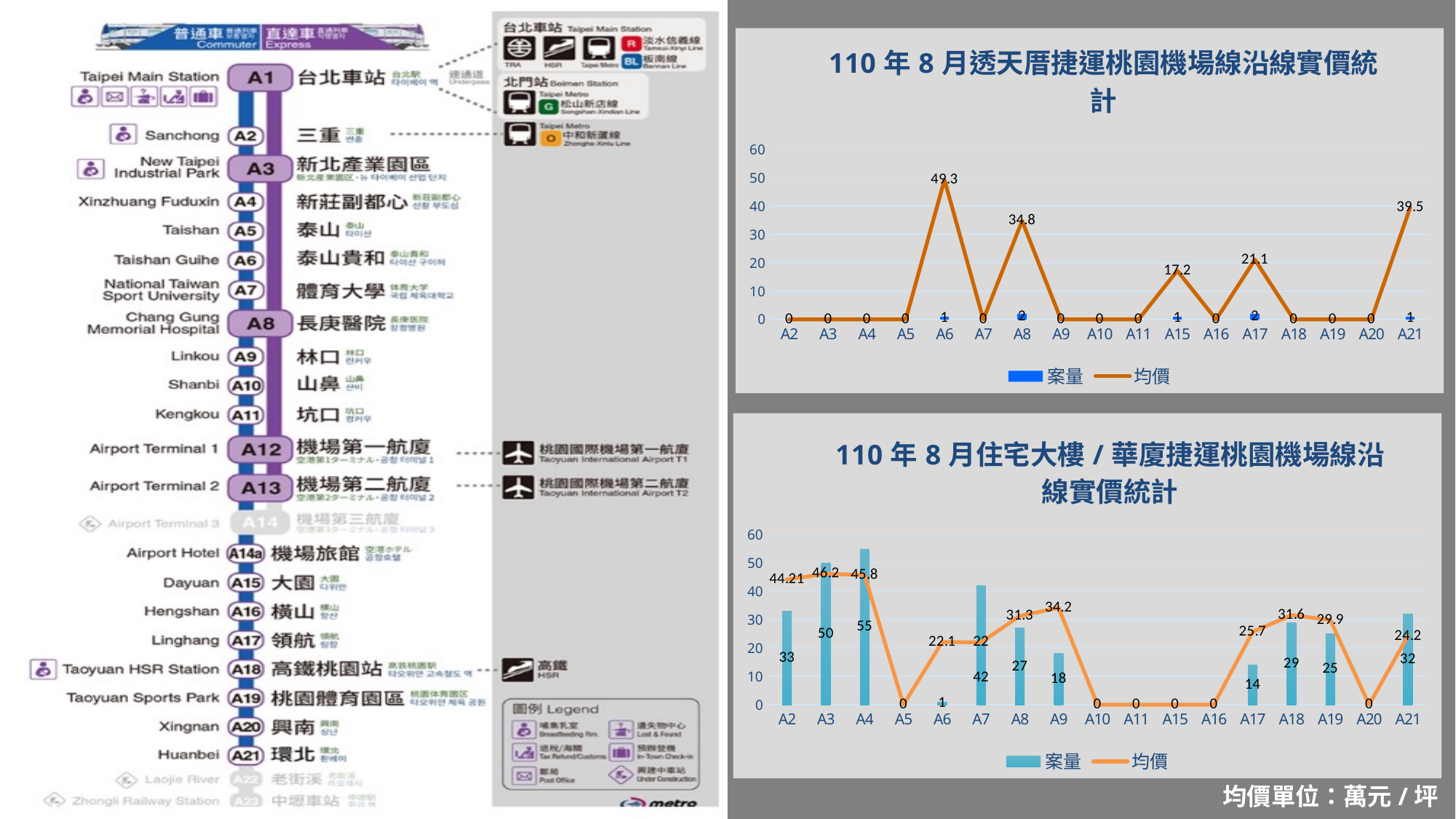
According to the note at the bottom right of the slide, what is the unit of 均價? 萬元 / 坪 In the bottom chart (110 年 8 月住宅大樓 / 華廈捷運桃園機場線沿線實價統計), which station has the highest 案量? A4 In the top chart (110 年 8 月透天厝捷運桃園機場線沿線實價統計), what is the difference between the 均價 for A21 and A8? 4.7 In the top chart (110 年 8 月透天厝捷運桃園機場線沿線實價統計), how many series does the legend list? 2 In the top chart (110 年 8 月透天厝捷運桃園機場線沿線實價統計), which station has the highest 均價? A6 In the bottom chart (110 年 8 月住宅大樓 / 華廈捷運桃園機場線沿線實價統計), what is the 均價 value for A2? 44.21 In the top chart (110 年 8 月透天厝捷運桃園機場線沿線實價統計), what is the 案量 value for A17? 2 In the bottom chart (110 年 8 月住宅大樓 / 華廈捷運桃園機場線沿線實價統計), what is the 案量 value for A7? 42 How many stations are shown on the x axis of the bottom chart (110 年 8 月住宅大樓 / 華廈捷運桃園機場線沿線實價統計)? 17 In the top chart (110 年 8 月透天厝捷運桃園機場線沿線實價統計), what is the 均價 value for A6? 49.3 In the bottom chart (110 年 8 月住宅大樓 / 華廈捷運桃園機場線沿線實價統計), which is larger, the 均價 for A9 or for A8? A9 In the bottom chart (110 年 8 月住宅大樓 / 華廈捷運桃園機場線沿線實價統計), what is the difference between the 案量 for A3 and A2? 17